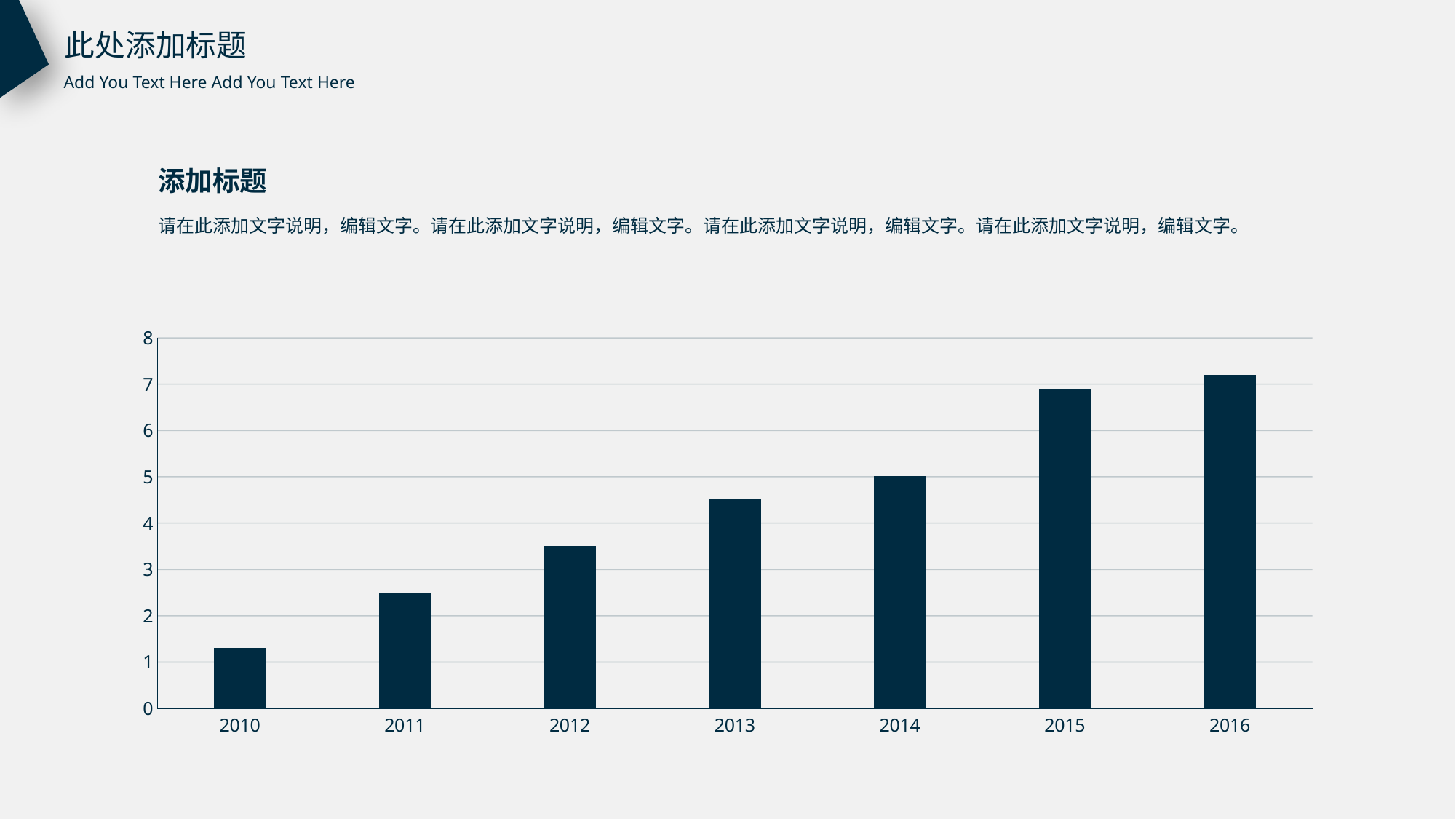
Is the value for 2015 greater or less than 6? greater What kind of chart is shown on the slide? bar chart How many years are shown on the x axis of the chart? 7 Which is larger, the value for 2011 or the value for 2013? 2013 Which year has the highest bar in the chart? 2016 Is the value for 2012 greater or less than 3? greater Do the bar values rise or fall from 2010 to 2016? rise Which year has the lowest bar in the chart? 2010 Is the value for 2016 greater or less than 7? greater What is the highest value shown on the y axis of the chart? 8